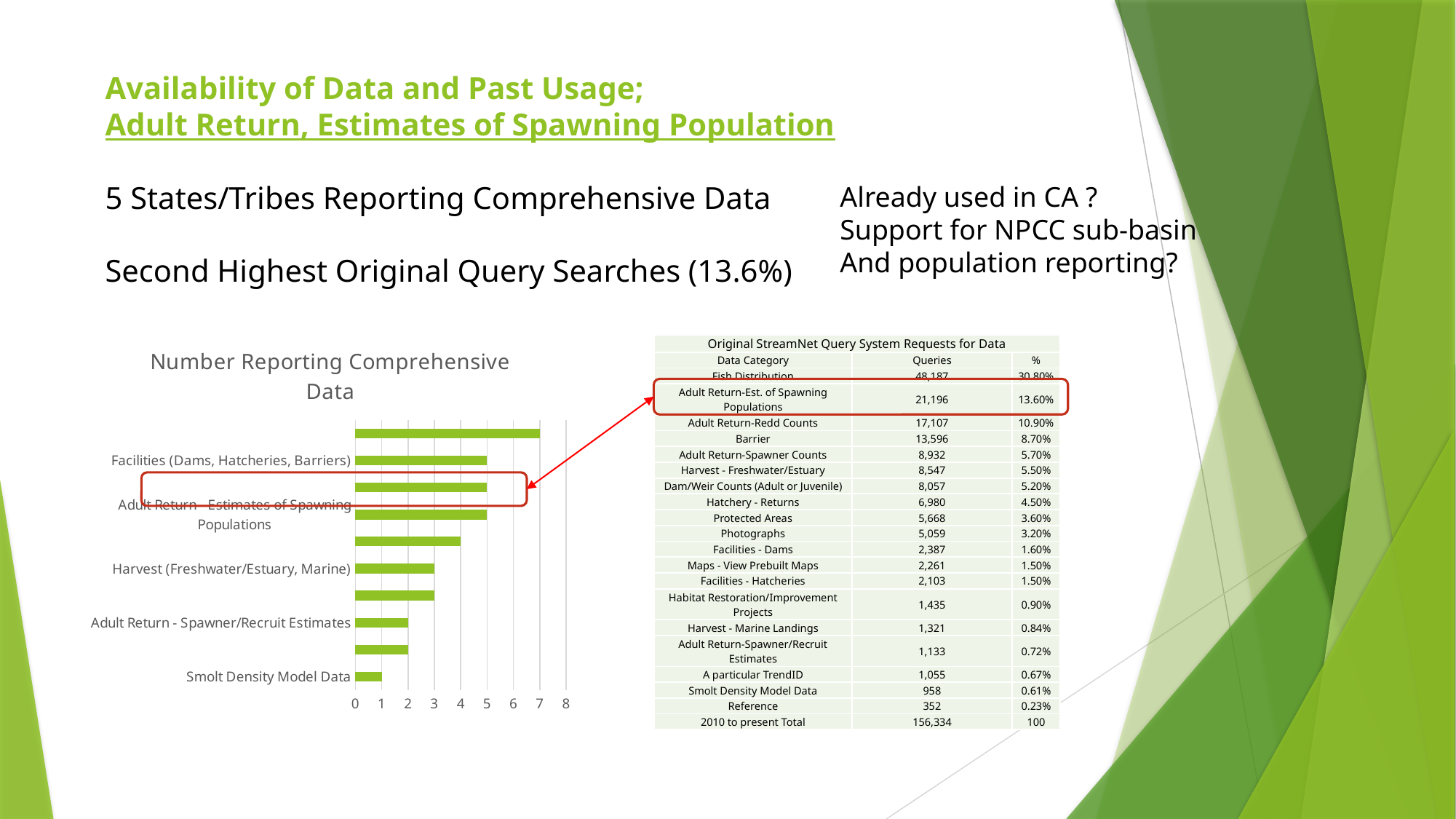
In the 'Number Reporting Comprehensive Data' chart, which is larger: Facilities (Dams, Hatcheries, Barriers) or Harvest (Freshwater/Estuary, Marine)? Facilities (Dams, Hatcheries, Barriers) In the 'Number Reporting Comprehensive Data' chart, what is the value for Smolt Density Model Data? 1 How many bars are plotted in the 'Number Reporting Comprehensive Data' chart? 10 In the 'Number Reporting Comprehensive Data' chart, which category has the lowest value? Smolt Density Model Data In the 'Number Reporting Comprehensive Data' chart, what is the value for Adult Return - Spawner/Recruit Estimates? 2 In the 'Number Reporting Comprehensive Data' chart, what is the value for Adult Return - Estimates of Spawning Populations? 5 In the 'Number Reporting Comprehensive Data' chart, is the value for Smolt Density Model Data greater or less than 2? less In the 'Number Reporting Comprehensive Data' chart, what is the difference between Facilities (Dams, Hatcheries, Barriers) and Harvest (Freshwater/Estuary, Marine)? 2 What kind of chart is 'Number Reporting Comprehensive Data'? bar chart What is the highest value shown on the x axis of the 'Number Reporting Comprehensive Data' chart? 8 In the 'Number Reporting Comprehensive Data' chart, what is the value for Facilities (Dams, Hatcheries, Barriers)? 5 In the 'Number Reporting Comprehensive Data' chart, what is the value for Harvest (Freshwater/Estuary, Marine)? 3